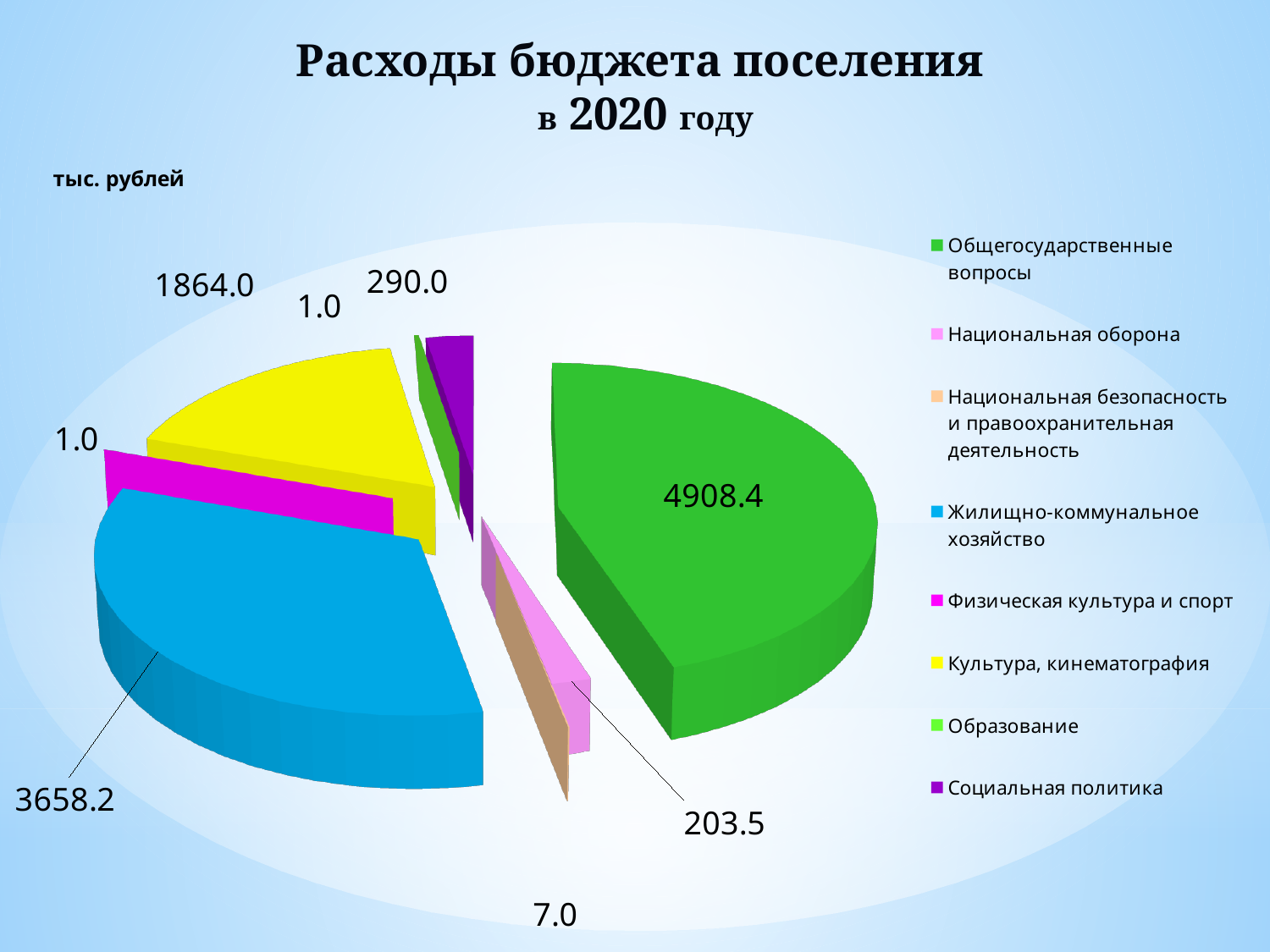
What kind of chart is shown on the slide? Pie chart What is the value for Культура, кинематография? 1864.0 What is the difference between the values for Общегосударственные вопросы and Жилищно-коммунальное хозяйство? 1250.2 What is the value for Национальная оборона? 203.5 Which is larger, the value for Культура, кинематография or the value for Социальная политика? Культура, кинематография What unit of measurement is stated on the slide for the chart values? тыс. рублей What is the value for Общегосударственные вопросы? 4908.4 Which category has the largest share of the pie? Общегосударственные вопросы How many categories does the legend list? 8 What is the value for Социальная политика? 290.0 What is the value for Жилищно-коммунальное хозяйство? 3658.2 What colour is the slice for Жилищно-коммунальное хозяйство? Blue